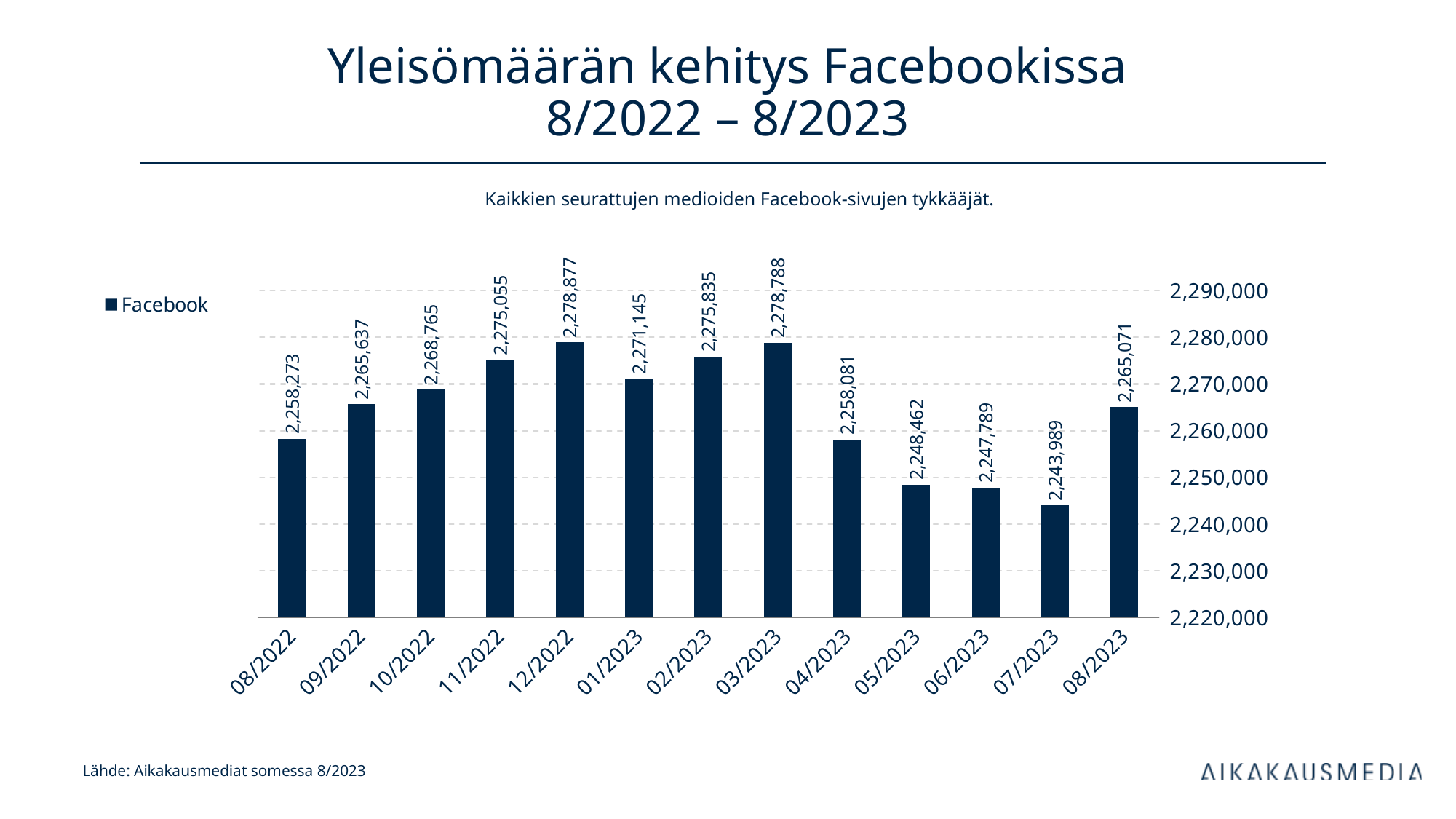
What is the value for 08/2023? 2,265,071 How many months are shown on the x axis? 13 Which is larger, the value for 11/2022 or the value for 04/2023? 11/2022 How many series does the legend list? 1 Which month has the lowest value? 07/2023 What is the difference between the values for 12/2022 and 08/2022? 20,604 What is the difference between the values for 08/2023 and 07/2023? 21,082 Which month has the highest value? 12/2022 What is the value for 12/2022? 2,278,877 What type of chart is shown on the slide? bar chart What is the name of the series shown in the legend? Facebook What is the value for 07/2023? 2,243,989